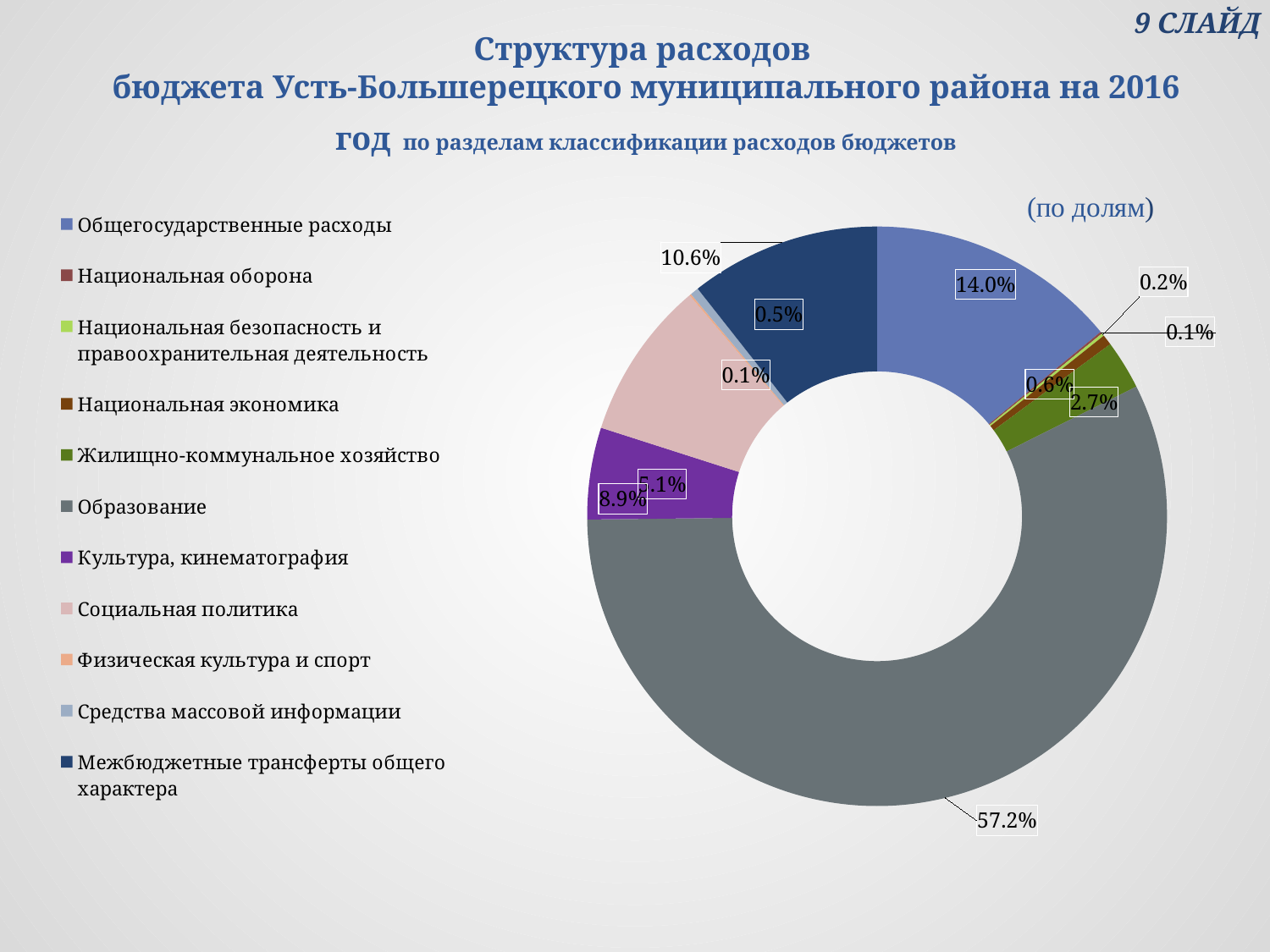
Which is larger: the share for Общегосударственные расходы or the share for Межбюджетные трансферты общего характера? Общегосударственные расходы What share of expenditures goes to Межбюджетные трансферты общего характера? 10.6% What share of expenditures goes to Социальная политика? 8.9% What share of expenditures goes to Жилищно-коммунальное хозяйство? 2.7% Which category has the largest share of expenditures? Образование What is the difference between the share for Социальная политика and the share for Культура, кинематография? 3.8% What share of expenditures goes to Образование? 57.2% What text appears in parentheses above the chart? (по долям) What kind of chart is shown on the slide? Doughnut (pie) chart What is the difference between the share for Образование and the share for Общегосударственные расходы? 43.2% What share of expenditures goes to Общегосударственные расходы? 14.0% How many categories does the legend list? 11